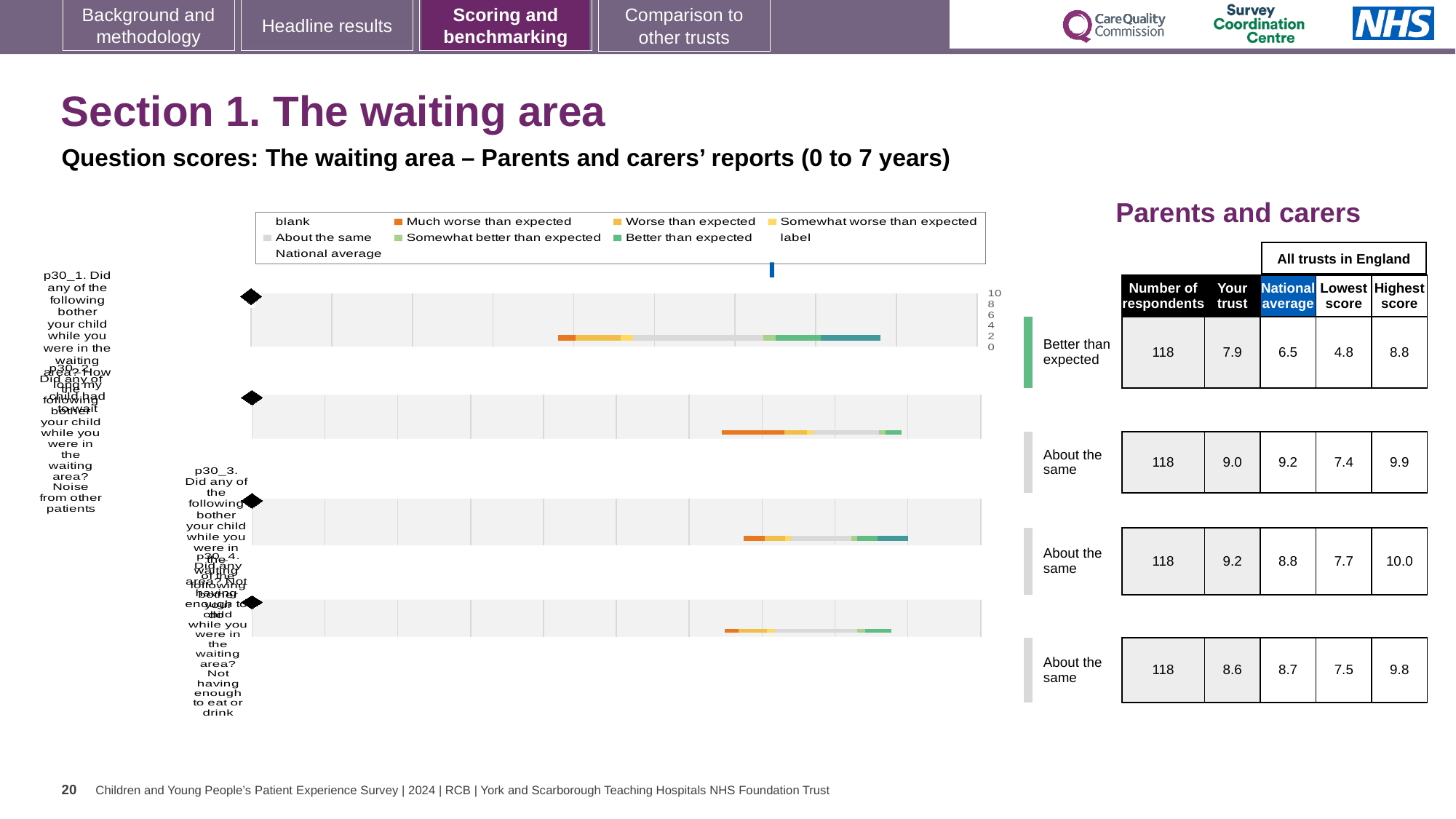
What is the highest tick value shown on the chart's score axis? 10 According to the table beside the chart, what is the 'Your trust' score for the first question row (p30_1)? 7.9 For the first question row (p30_1), which is larger: the 'Your trust' score or the national average? Your trust Which question row has the highest 'Your trust' score in the table beside the chart? the third row (p30_3), 9.2 What kind of chart is shown on the slide? bar chart According to the table beside the chart, how many respondents answered each question? 118 In the chart legend, what colour represents 'Much worse than expected'? orange According to the table beside the chart, what is the highest score across all trusts in England for the first question row (p30_1)? 8.8 Which question row has the lowest 'Your trust' score in the table beside the chart? the first row (p30_1), 7.9 How many question rows (bars) does the chart show? 4 For the third question row (p30_3), what is the difference between the 'Your trust' score (9.2) and the national average (8.8)? 0.4 What benchmark category is shown next to the first question row (p30_1)? Better than expected